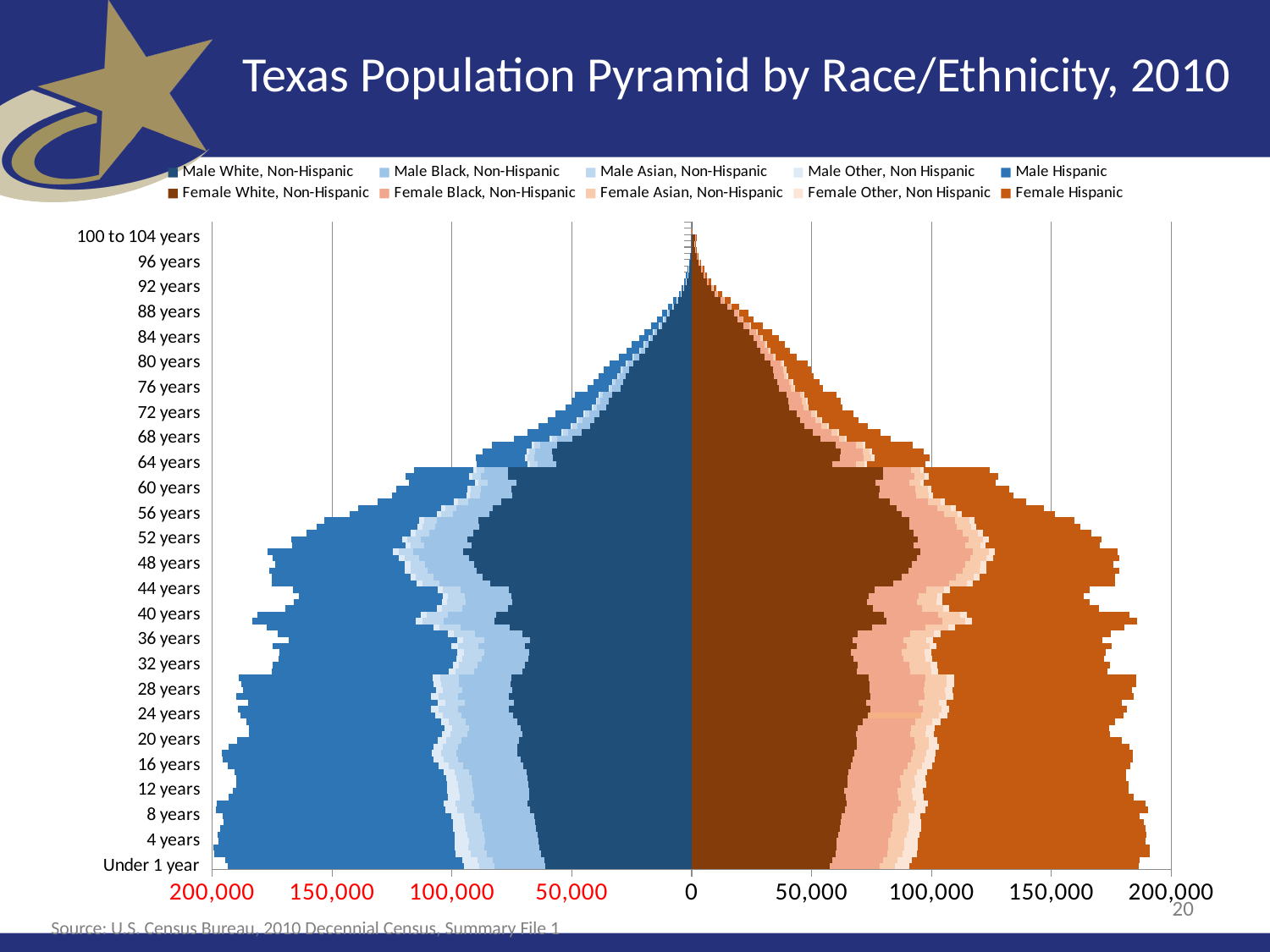
How many series does the legend list? 10 What is the title of the chart? Texas Population Pyramid by Race/Ethnicity, 2010 What kind of chart is shown on the slide? Bar chart (population pyramid) Is the total male population for the 80 years age group greater or less than 50,000? less Which legend entry is shown in the darkest blue colour? Male Hispanic Is the total male population for the 100 to 104 years age group greater or less than 50,000? less Do the total bar lengths generally get shorter or longer as age increases from Under 1 year to 100 to 104 years? Shorter Is the total female population for the Under 1 year age group greater or less than 150,000? greater At 88 years, which side of the pyramid is larger, male or female? Female Which age group has a larger total male population, Under 1 year or 100 to 104 years? Under 1 year